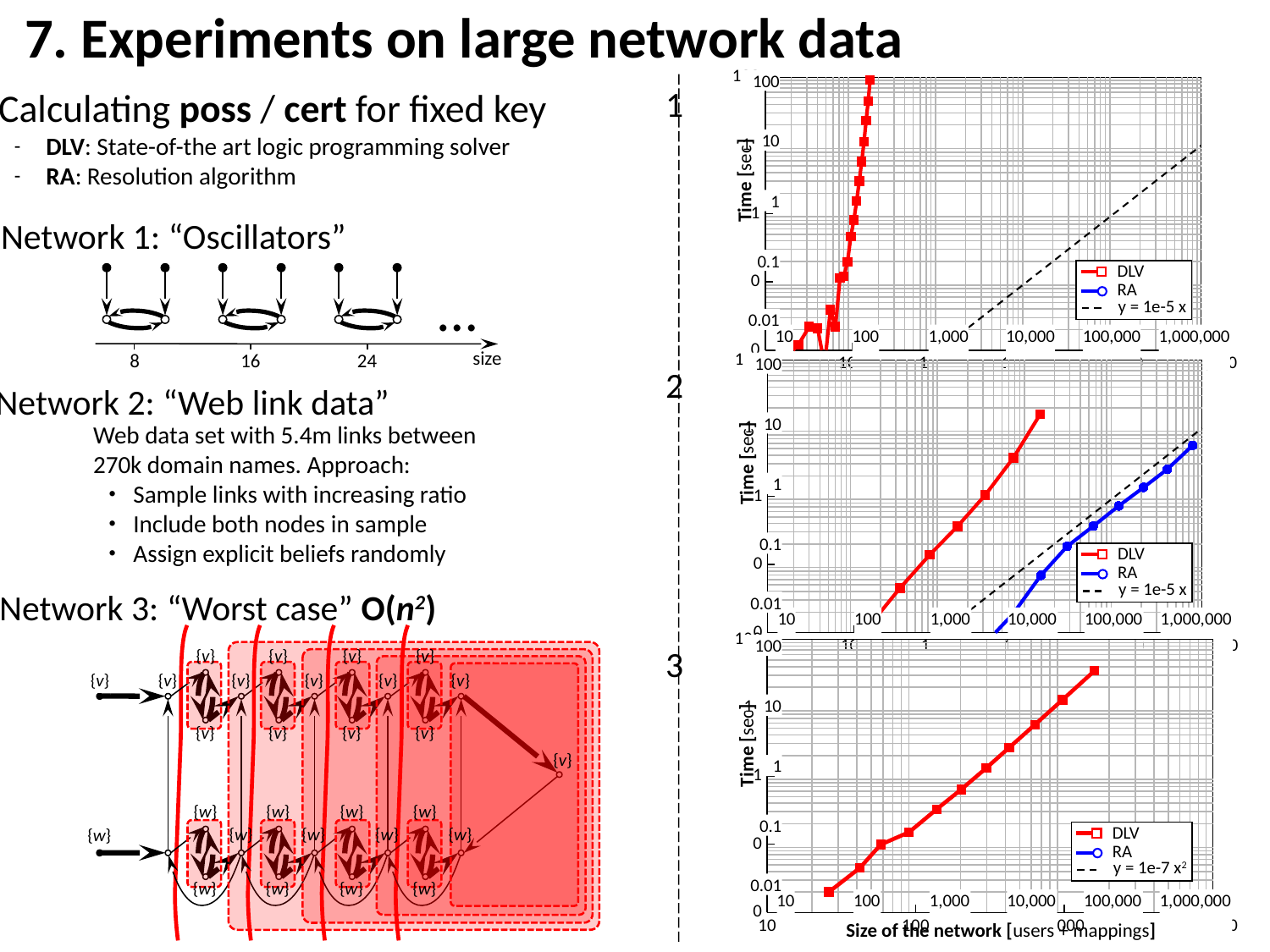
In the top chart (chart 1), is the DLV time at network size 10 greater or less than 0.1? less How many series does the legend of the top chart (chart 1) list? 3 In the middle chart (chart 2), is the RA time at network size 10,000 greater or less than 0.1? less In the middle chart (chart 2), what colour is the RA line? blue In the bottom chart (chart 3), does the DLV time rise or fall as the network size increases? rise In the top chart (chart 1), what are the legend entries? DLV, RA, y = 1e-5 x What kind of chart is the top chart (chart 1) on the right of the slide? line chart In the bottom chart (chart 3), is the DLV time at network size 100,000 greater or less than 10? greater In the middle chart (chart 2), at network size 10,000, which series has the larger time, DLV or RA? DLV In the bottom chart (chart 3), what reference function is listed in the legend? y = 1e-7 x²